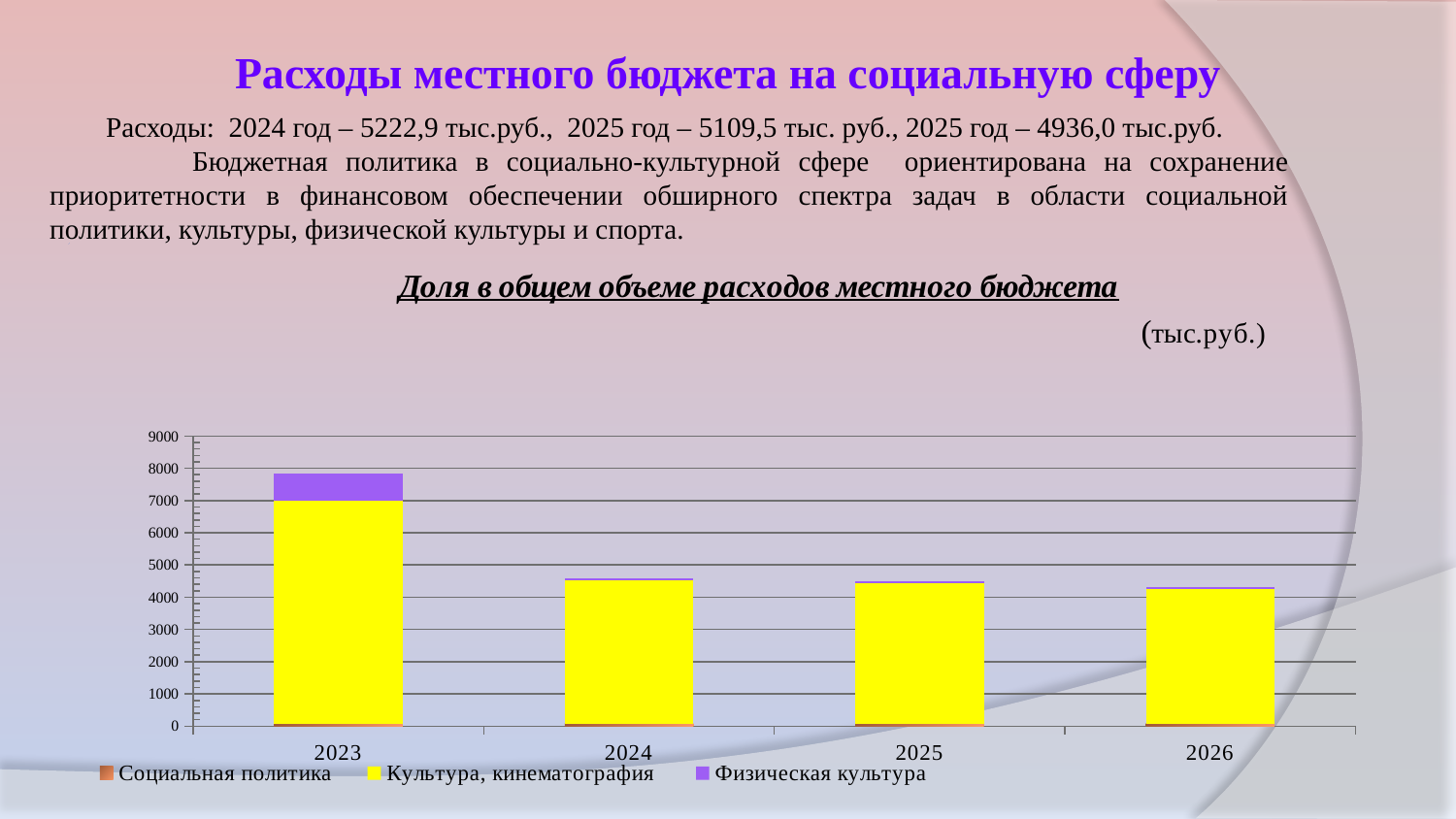
Is the total of the stacked bar for 2023 greater or less than 7000? greater Is the total of the stacked bar for 2024 greater or less than 5000? less How many years are shown on the x axis of the chart? 4 Is the value for Культура, кинематография in 2023 greater or less than 6000? greater Which series is shown in yellow in the chart? Культура, кинематография What kind of chart is shown on the slide? bar chart Which year has the shortest stacked bar? 2026 Which stacked bar is taller, 2023 or 2024? 2023 Which year has the tallest stacked bar? 2023 Do the stacked bar totals rise or fall from 2023 to 2026? fall How many series does the chart legend list? 3